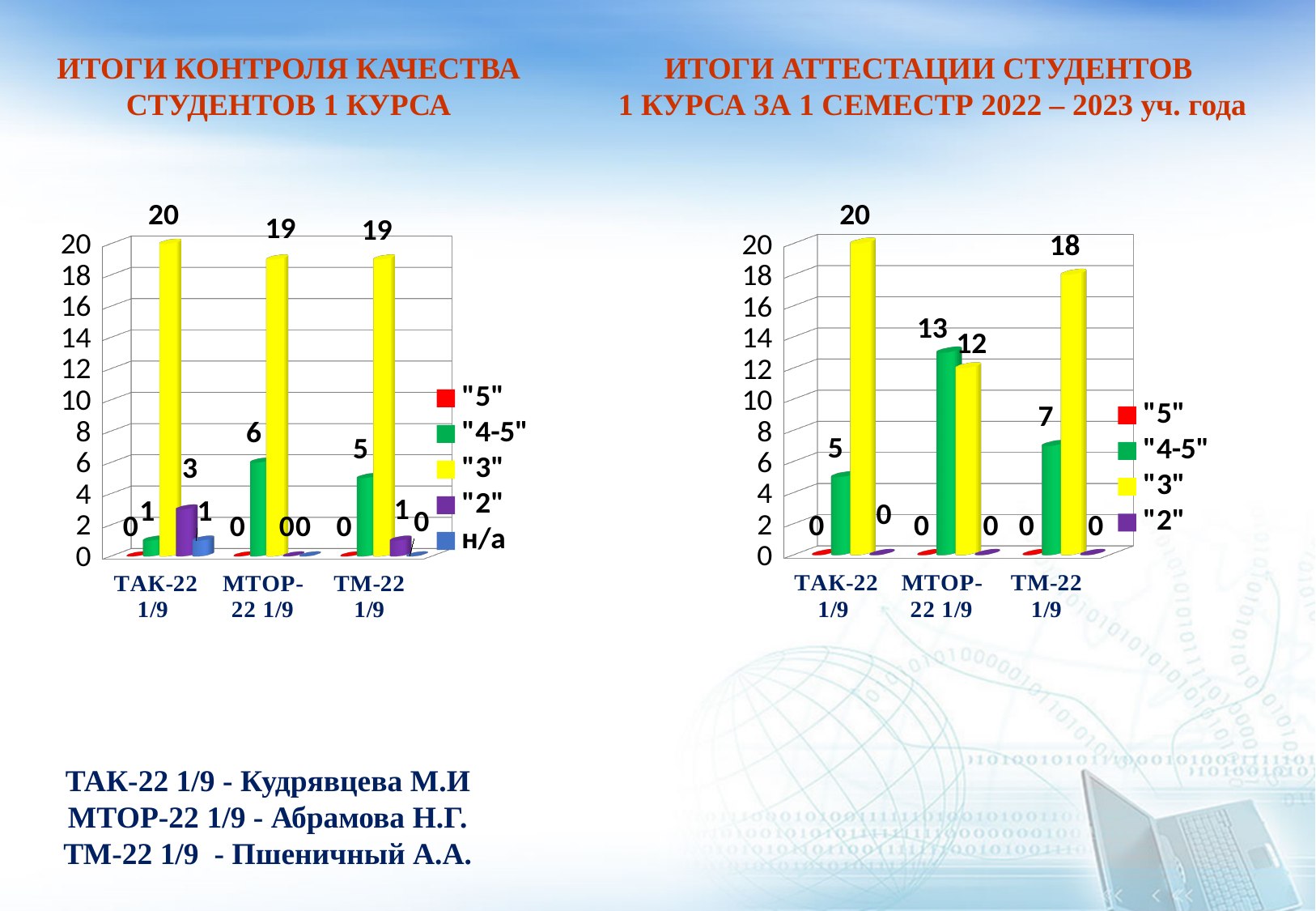
In the left chart (ИТОГИ КОНТРОЛЯ КАЧЕСТВА СТУДЕНТОВ 1 КУРСА), what is the value of the "4-5" series for МТОР-22 1/9? 6 In the left chart (ИТОГИ КОНТРОЛЯ КАЧЕСТВА СТУДЕНТОВ 1 КУРСА), how many series does the legend list? 5 What type of chart is the left chart (ИТОГИ КОНТРОЛЯ КАЧЕСТВА СТУДЕНТОВ 1 КУРСА)? Bar chart In the left chart (ИТОГИ КОНТРОЛЯ КАЧЕСТВА СТУДЕНТОВ 1 КУРСА), what is the value of the "2" series for ТАК-22 1/9? 3 In the right chart (ИТОГИ АТТЕСТАЦИИ СТУДЕНТОВ 1 КУРСА), what is the value of the "3" series for ТМ-22 1/9? 18 In the right chart (ИТОГИ АТТЕСТАЦИИ СТУДЕНТОВ 1 КУРСА), which group has the lowest value for the "3" series? МТОР-22 1/9 In the right chart (ИТОГИ АТТЕСТАЦИИ СТУДЕНТОВ 1 КУРСА), what is the difference between the "4-5" and "3" values for МТОР-22 1/9? 1 In the right chart (ИТОГИ АТТЕСТАЦИИ СТУДЕНТОВ 1 КУРСА), what is the value of the "4-5" series for МТОР-22 1/9? 13 How many groups (categories) are shown on the x axis of the right chart (ИТОГИ АТТЕСТАЦИИ СТУДЕНТОВ 1 КУРСА)? 3 In the right chart (ИТОГИ АТТЕСТАЦИИ СТУДЕНТОВ 1 КУРСА), is the "4-5" value for ТМ-22 1/9 larger or smaller than the "4-5" value for ТАК-22 1/9? larger In the left chart (ИТОГИ КОНТРОЛЯ КАЧЕСТВА СТУДЕНТОВ 1 КУРСА), which group has the highest value for the "4-5" series? МТОР-22 1/9 In the left chart (ИТОГИ КОНТРОЛЯ КАЧЕСТВА СТУДЕНТОВ 1 КУРСА), what is the value of the "3" series for ТАК-22 1/9? 20